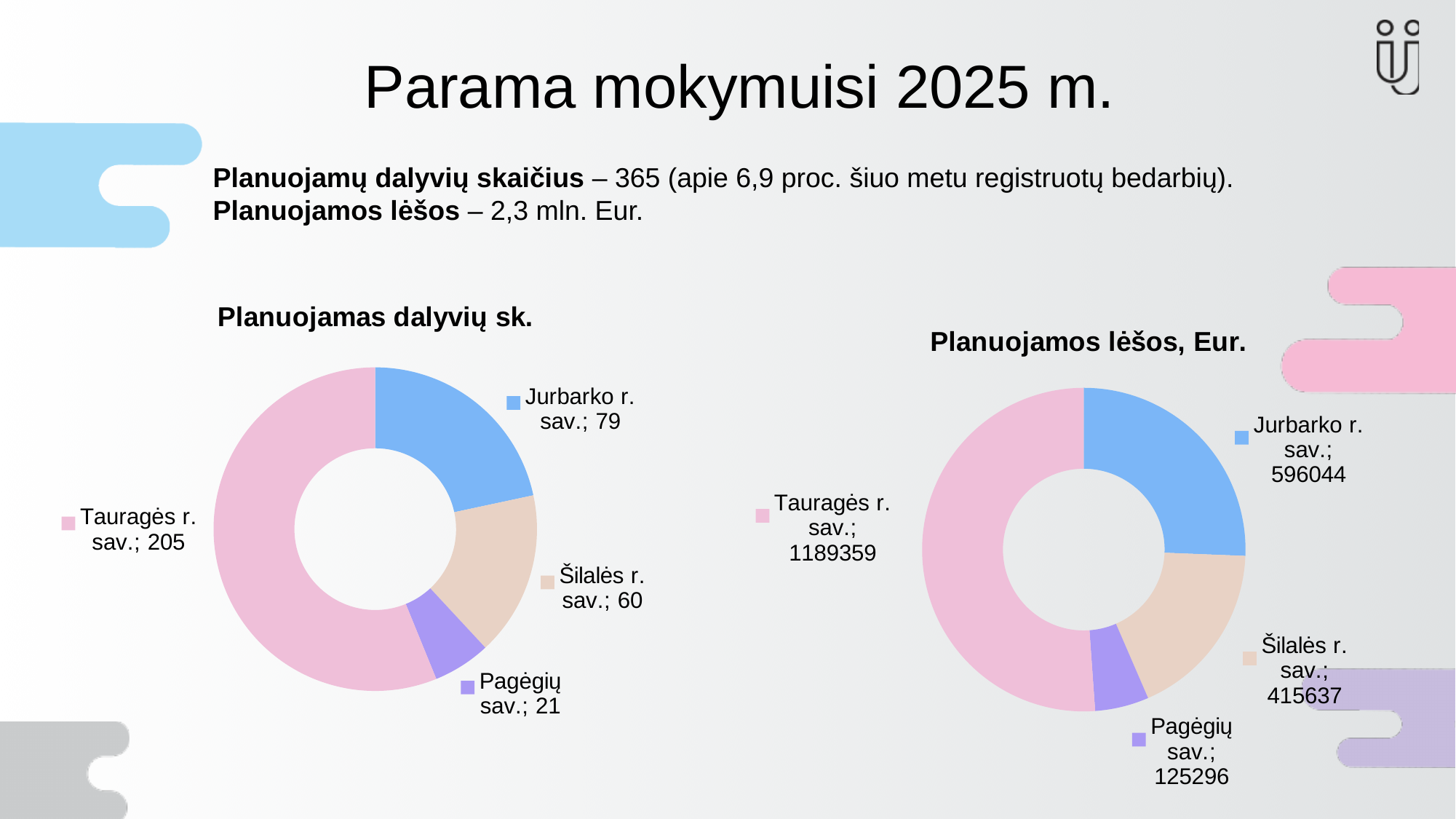
In the chart titled "Planuojamas dalyvių sk.", what is the value for Tauragės r. sav.? 205 In the chart titled "Planuojamos lėšos, Eur.", which is larger: the value for Šilalės r. sav. or Pagėgių sav.? Šilalės r. sav. In the chart titled "Planuojamas dalyvių sk.", what is the difference between the values for Jurbarko r. sav. and Šilalės r. sav.? 19 In the chart titled "Planuojamas dalyvių sk.", what is the value for Pagėgių sav.? 21 In the chart titled "Planuojamos lėšos, Eur.", what is the value for Šilalės r. sav.? 415637 In the chart titled "Planuojamos lėšos, Eur.", what is the difference between the values for Tauragės r. sav. and Jurbarko r. sav.? 593315 In the chart titled "Planuojamos lėšos, Eur.", what is the value for Jurbarko r. sav.? 596044 In the chart titled "Planuojamas dalyvių sk.", what colour is the slice for Pagėgių sav.? Purple In the chart titled "Planuojamas dalyvių sk.", which category has the highest value? Tauragės r. sav. How many categories does the chart titled "Planuojamas dalyvių sk." show? 4 In the chart titled "Planuojamos lėšos, Eur.", which category has the lowest value? Pagėgių sav. What kind of chart is the chart titled "Planuojamos lėšos, Eur."? Doughnut (pie) chart